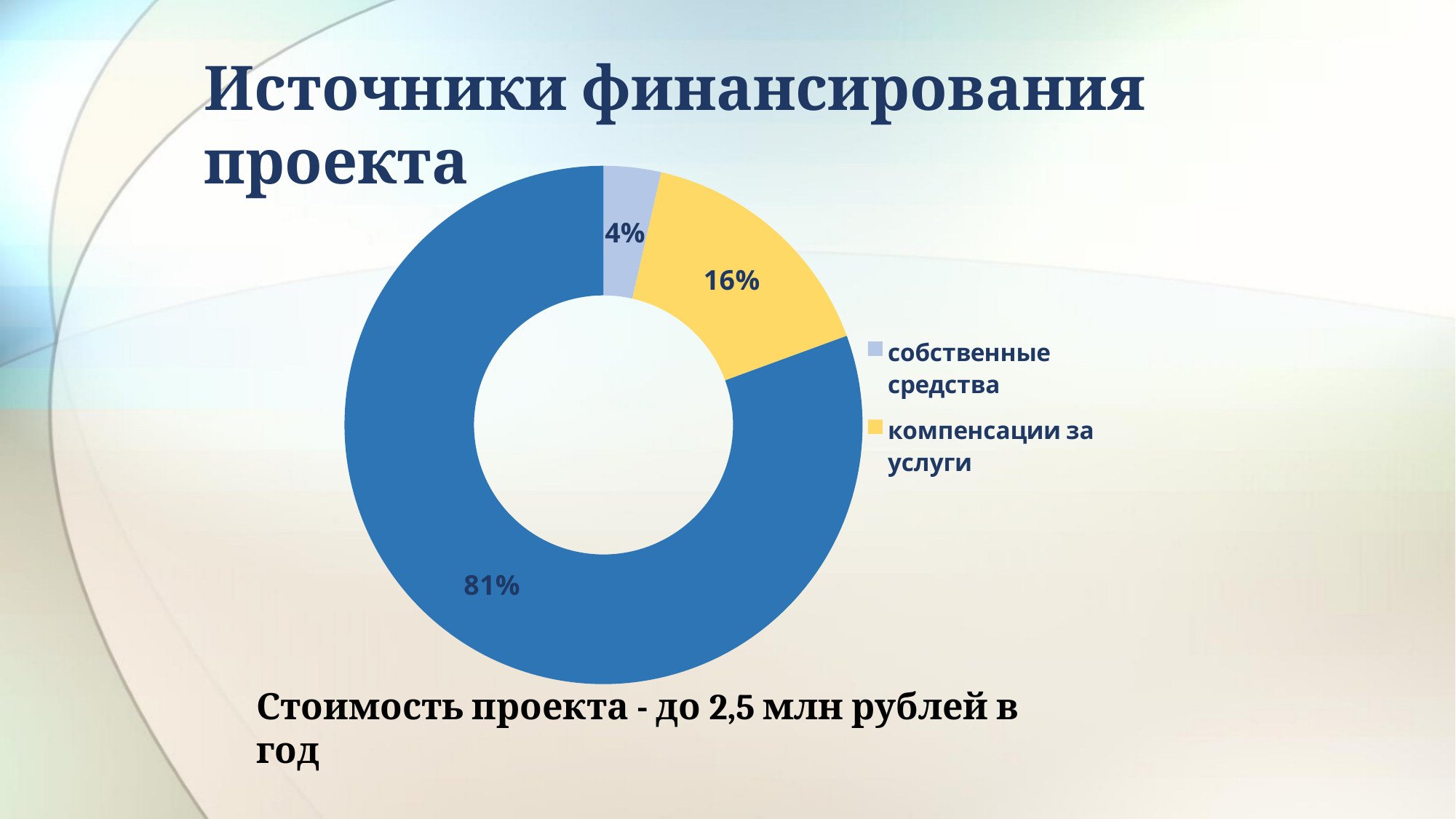
What is the value printed on the largest slice of the chart? 81% What share of the chart is labelled "собственные средства"? 4% What is the difference in percentage points between the "компенсации за услуги" slice and the "собственные средства" slice? 12 What is the title of the slide containing the chart? Источники финансирования проекта How many slices does the doughnut chart have? 3 What share of the chart is labelled "компенсации за услуги"? 16% What colour is the slice for "компенсации за услуги"? yellow Which is larger: the slice for "собственные средства" or the slice for "компенсации за услуги"? компенсации за услуги Which legend entry corresponds to the smallest slice of the chart? собственные средства What kind of chart is shown on the slide? doughnut chart How many entries does the legend list? 2